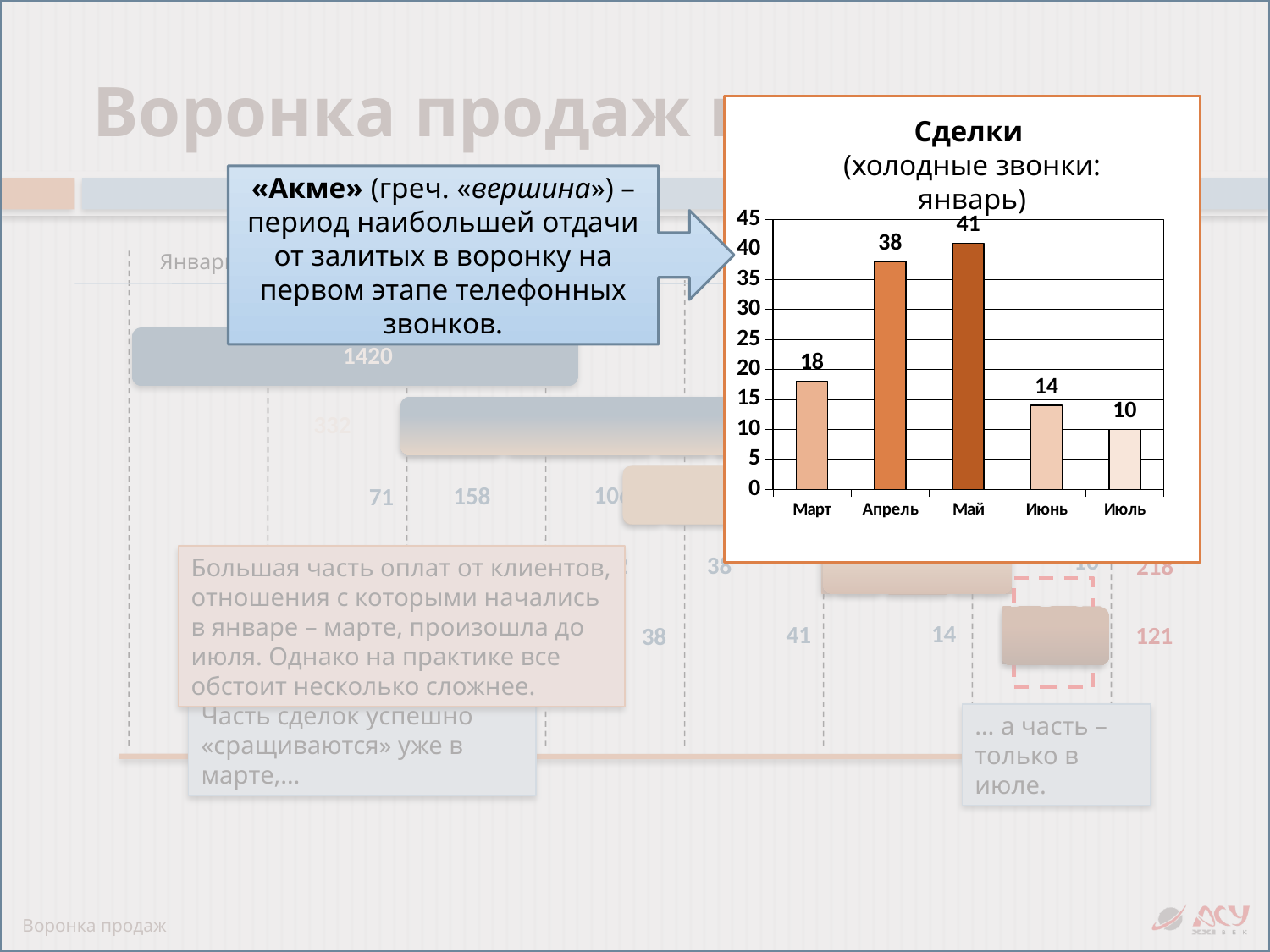
What is the value for Апрель in the chart? 38 What is the difference between the values for Март and Июнь? 4 Which month has the highest value in the chart? Май What is the value for Март in the chart? 18 Which month has the lowest value in the chart? Июль Do the values rise or fall from Май to Июль? fall How many months are shown on the x axis of the chart? 5 Which is larger, the value for Март or the value for Июнь? Март What kind of chart is shown on the slide? bar chart What is the value for Июль in the chart? 10 What is the difference between the values for Май and Апрель? 3 What is the title of the chart? Сделки (холодные звонки: январь)